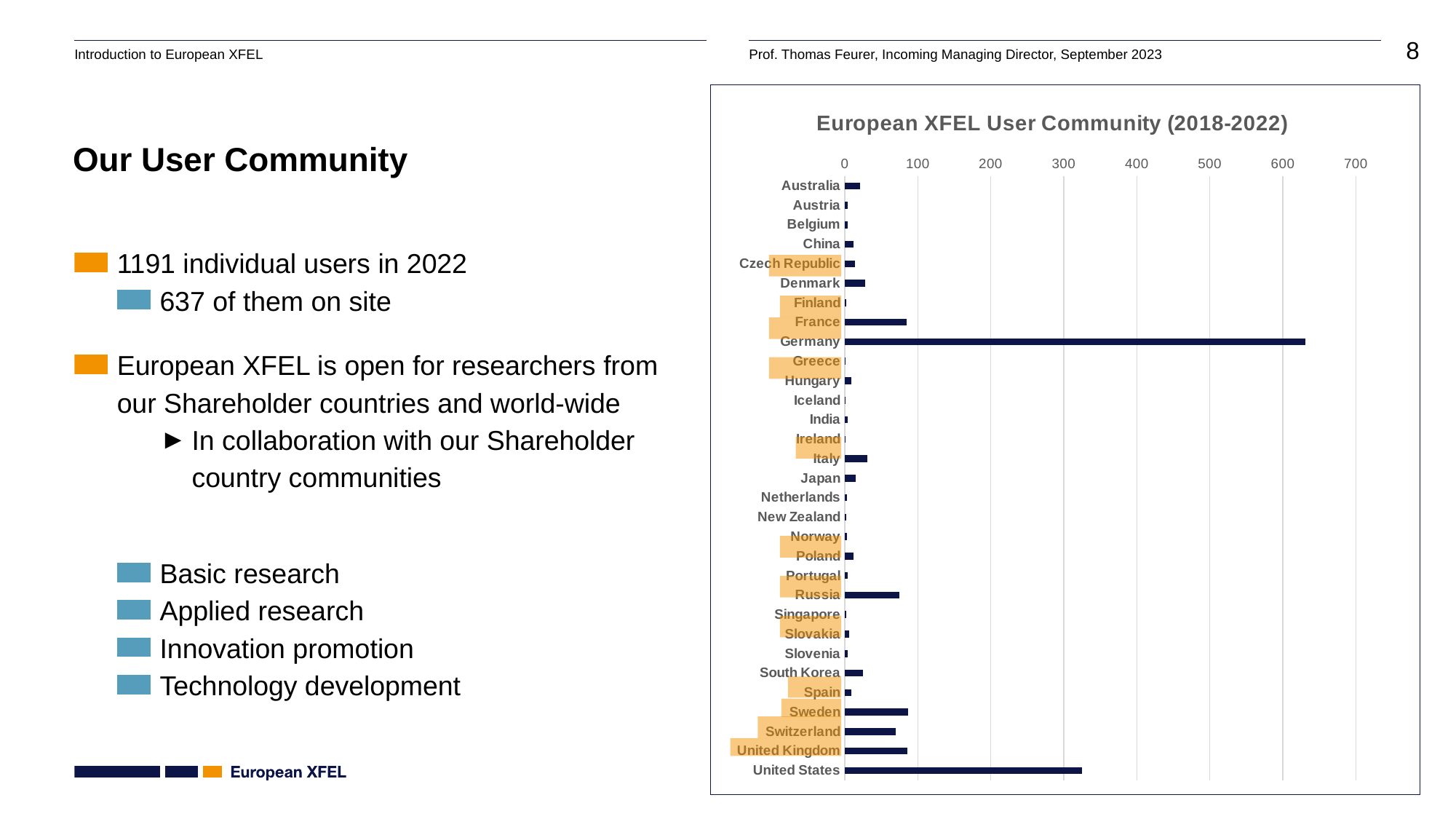
Which has a larger value, United States or France? United States Which country has the highest value in the chart? Germany Is the value for Italy greater or less than 100? less Which has a larger value, Germany or United States? Germany What kind of chart is shown on the slide? bar chart How many countries are listed in the chart? 31 Is the value for United States greater or less than 300? greater What is the title of the chart? European XFEL User Community (2018-2022) Is the value for Germany greater or less than 600? greater Which has a larger value, Russia or Denmark? Russia